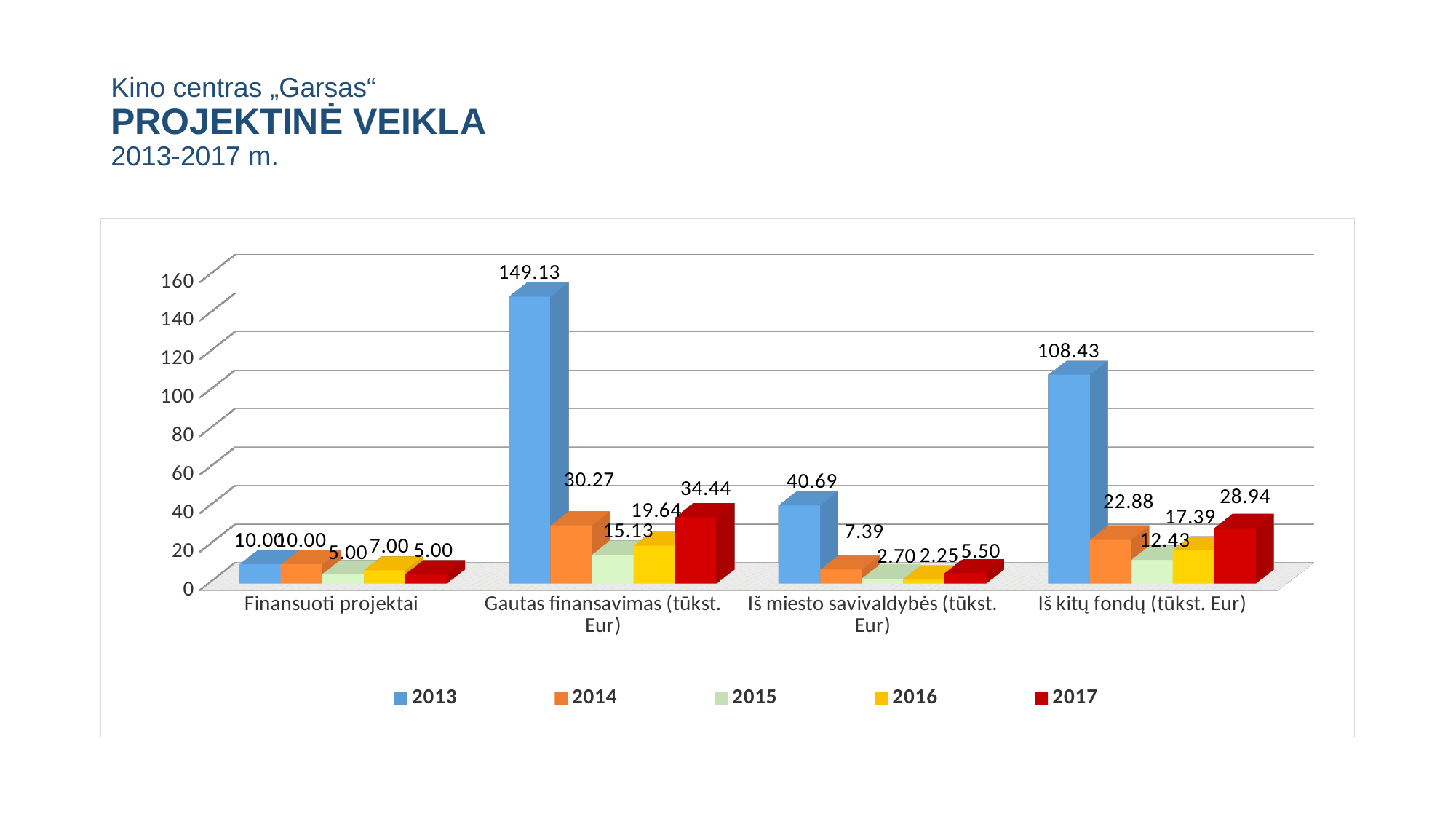
What kind of chart is shown on the slide? bar chart What is the value for 2013 in the "Gautas finansavimas (tūkst. Eur)" category? 149.13 What is the value for 2015 in the "Finansuoti projektai" category? 5.00 Which year has the lowest value in the "Iš miesto savivaldybės (tūkst. Eur)" category? 2016 What is the difference between the 2013 and 2014 values in the "Gautas finansavimas (tūkst. Eur)" category? 118.86 Which year has the highest value in the "Iš kitų fondų (tūkst. Eur)" category? 2013 What is the value for 2017 in the "Iš kitų fondų (tūkst. Eur)" category? 28.94 How many series does the chart legend list? 5 Is the 2013 value for "Iš kitų fondų (tūkst. Eur)" greater or less than 100? greater What is the value for 2016 in the "Iš miesto savivaldybės (tūkst. Eur)" category? 2.25 How many categories are shown on the x axis of the chart? 4 Which is larger in the "Iš kitų fondų (tūkst. Eur)" category: the 2014 value or the 2017 value? 2017